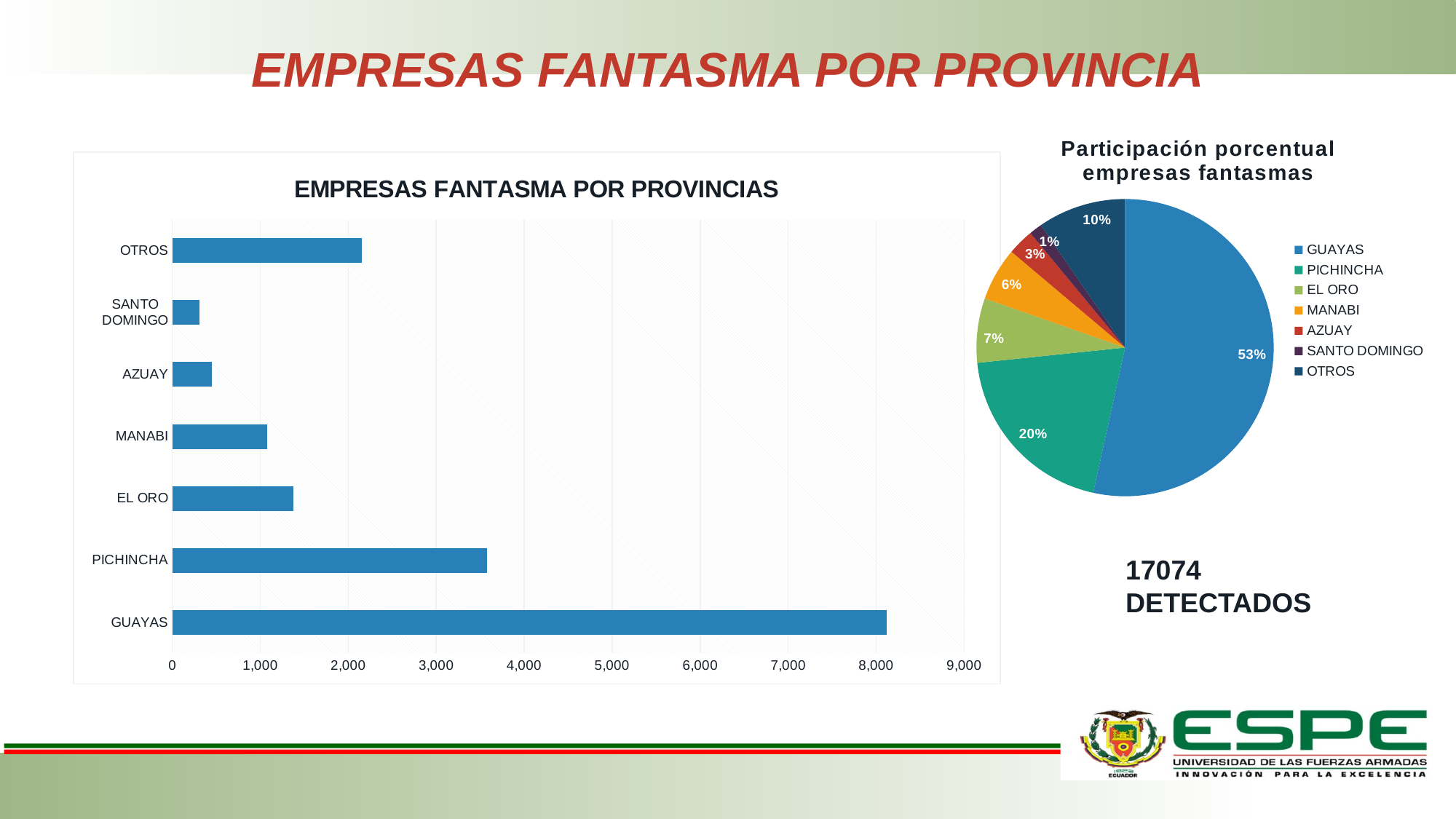
In the pie chart titled Participación porcentual empresas fantasmas, what is the difference between the shares of GUAYAS and OTROS? 43% In the pie chart titled Participación porcentual empresas fantasmas, what share does PICHINCHA have? 20% In the bar chart titled EMPRESAS FANTASMA POR PROVINCIAS, what kind of chart is it? bar chart In the bar chart titled EMPRESAS FANTASMA POR PROVINCIAS, which is larger, the value for EL ORO or the value for MANABI? EL ORO In the pie chart titled Participación porcentual empresas fantasmas, what share does GUAYAS have? 53% In the bar chart titled EMPRESAS FANTASMA POR PROVINCIAS, is the value for GUAYAS greater or less than 8,000? greater In the pie chart titled Participación porcentual empresas fantasmas, how many entries does the legend list? 7 In the bar chart titled EMPRESAS FANTASMA POR PROVINCIAS, is the value for OTROS greater or less than 2,000? greater In the bar chart titled EMPRESAS FANTASMA POR PROVINCIAS, is the value for PICHINCHA greater or less than 4,000? less In the bar chart titled EMPRESAS FANTASMA POR PROVINCIAS, which province has the highest value? GUAYAS In the bar chart titled EMPRESAS FANTASMA POR PROVINCIAS, which province has the lowest value? SANTO DOMINGO In the bar chart titled EMPRESAS FANTASMA POR PROVINCIAS, how many provinces (categories) are shown? 7